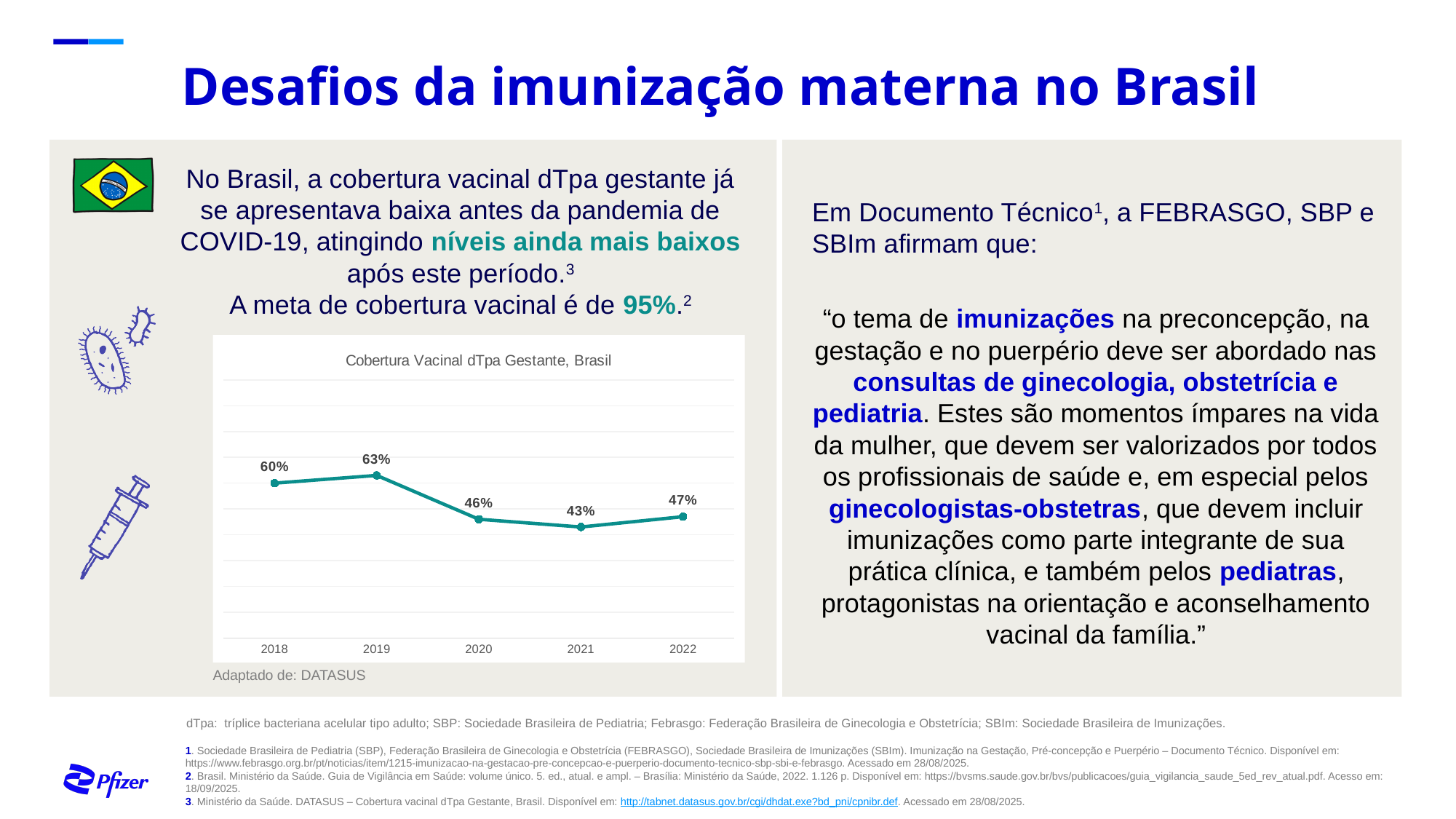
Which year had the highest vaccination coverage? 2019 What is the title of the chart? Cobertura Vacinal dTpa Gestante, Brasil What was the dTpa vaccination coverage in 2022? 47% Did vaccination coverage rise or fall from 2019 to 2021? fall How many years are plotted on the chart? 5 What type of chart is shown on the slide? line chart What is the source noted below the chart? Adaptado de: DATASUS Which year had higher coverage, 2020 or 2022? 2022 What was the dTpa vaccination coverage in 2021? 43% What was the dTpa vaccination coverage in 2018? 60% What is the difference in coverage between 2019 and 2021? 20% Which year had the lowest vaccination coverage? 2021